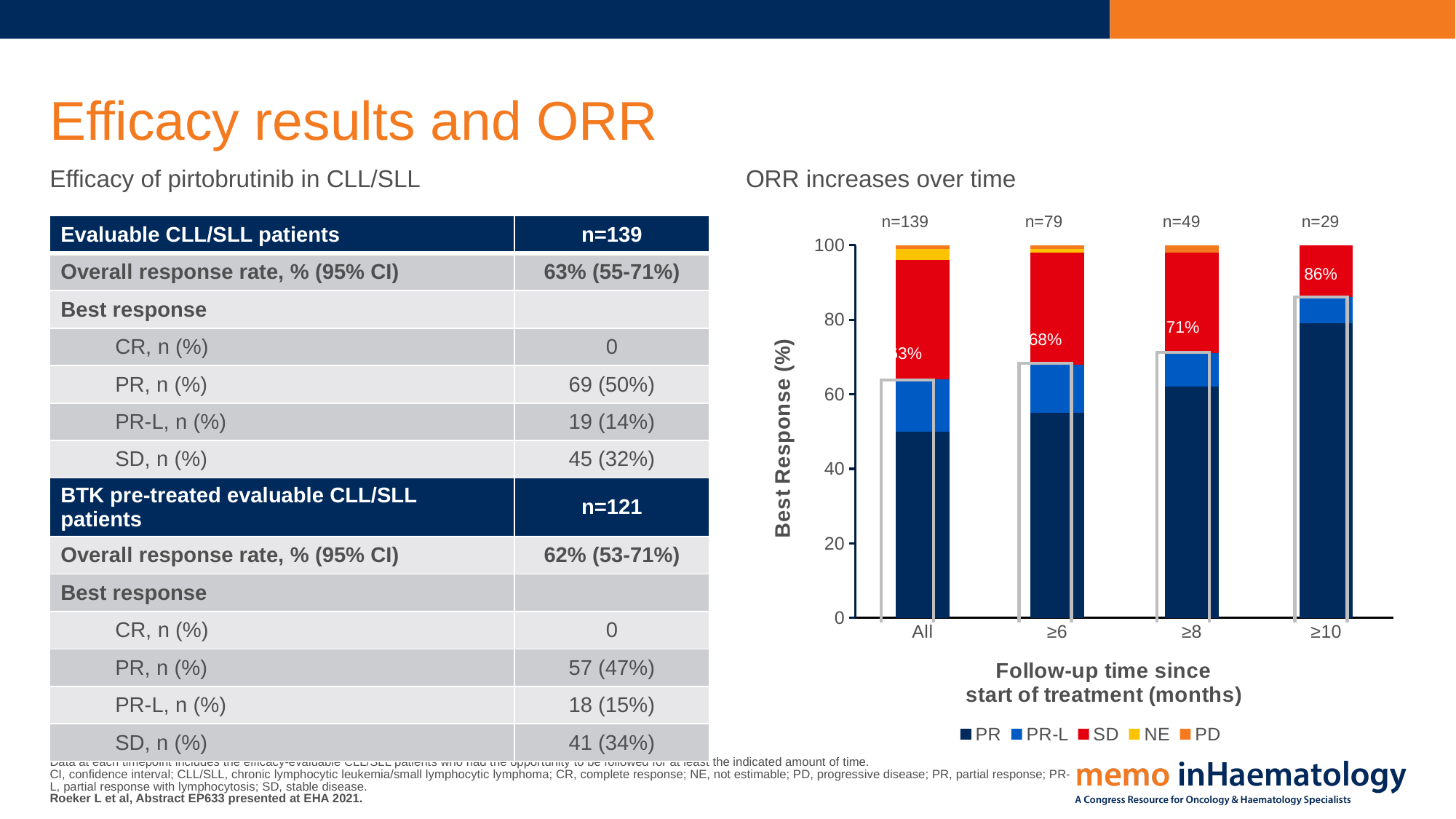
In the "ORR increases over time" chart, which has the larger ORR: the ≥6 group or the ≥8 group? ≥8 How many follow-up time categories are shown on the x axis of the "ORR increases over time" chart? 4 In the "ORR increases over time" chart, what is the n value shown above the ≥6 months bar? n=79 In the "ORR increases over time" chart, is the PR segment for the ≥10 months group greater or less than 60? greater In the "ORR increases over time" chart, what is the ORR labelled for the ≥6 months group? 68% In the "ORR increases over time" chart, what is the difference between the ORR for ≥10 months and the ORR for ≥6 months? 18 percentage points In the "ORR increases over time" chart, what is the ORR labelled for the ≥10 months group? 86% What kind of chart is shown under "ORR increases over time"? Stacked bar chart In the "ORR increases over time" chart, what is the ORR labelled for the ≥8 months group? 71% How many series does the legend of the "ORR increases over time" chart list? 5 In the "ORR increases over time" chart, does the ORR rise or fall as follow-up time increases along the x axis? Rise In the "ORR increases over time" chart, which follow-up group has the highest ORR? ≥10